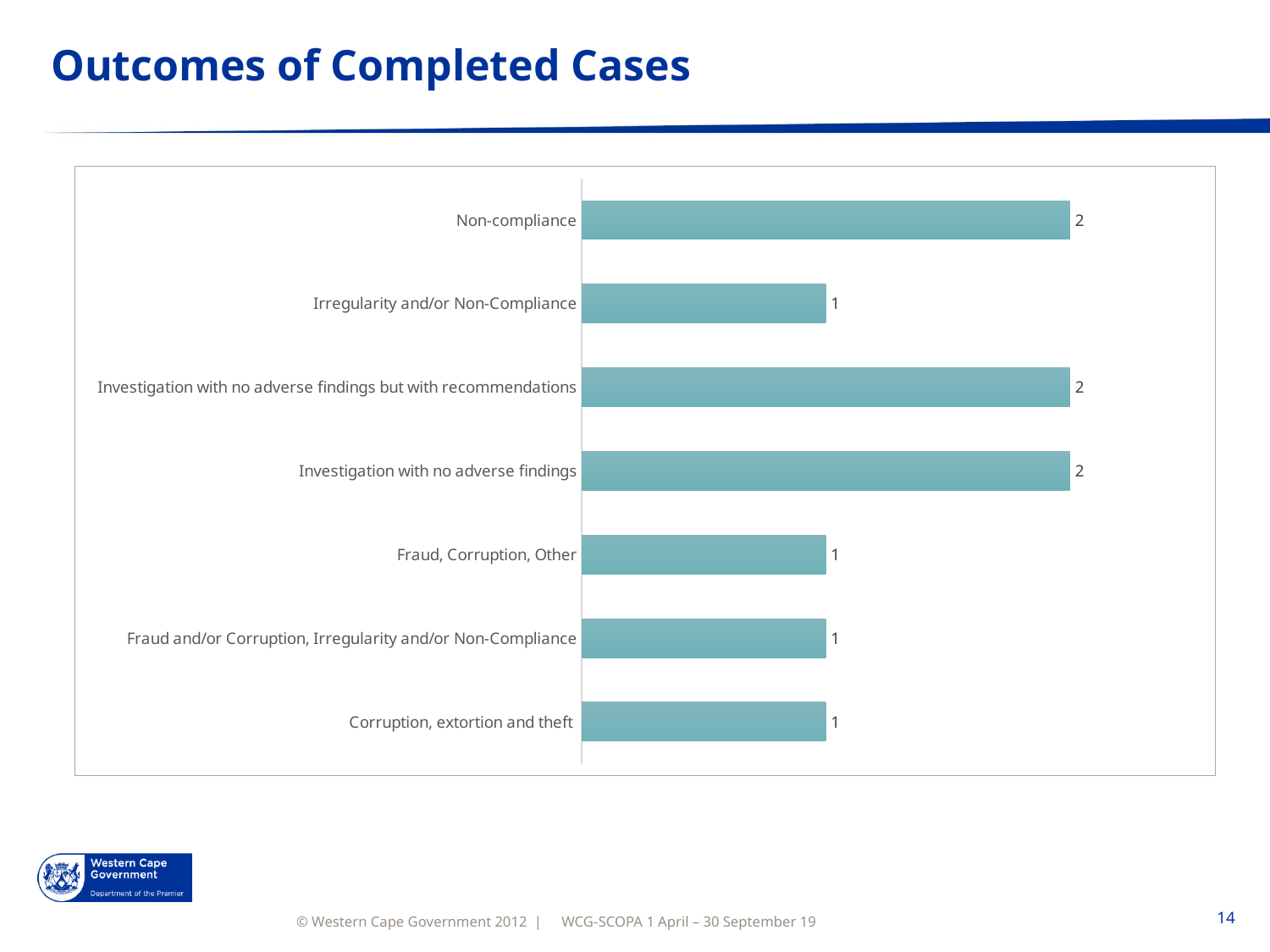
What is the value for Fraud, Corruption, Other? 1 What is the value for Investigation with no adverse findings but with recommendations? 2 How many categories are shown in the chart? 7 What is the value for Corruption, extortion and theft? 1 Which has the larger value, Non-compliance or Fraud, Corruption, Other? Non-compliance What is the title of the slide containing the chart? Outcomes of Completed Cases What kind of chart is shown on the slide? Bar chart What is the value for Irregularity and/or Non-Compliance? 1 What is the difference between the values for Non-compliance and Corruption, extortion and theft? 1 What is the value for Investigation with no adverse findings? 2 What is the value for Non-compliance? 2 Which has the larger value, Investigation with no adverse findings or Fraud and/or Corruption, Irregularity and/or Non-Compliance? Investigation with no adverse findings